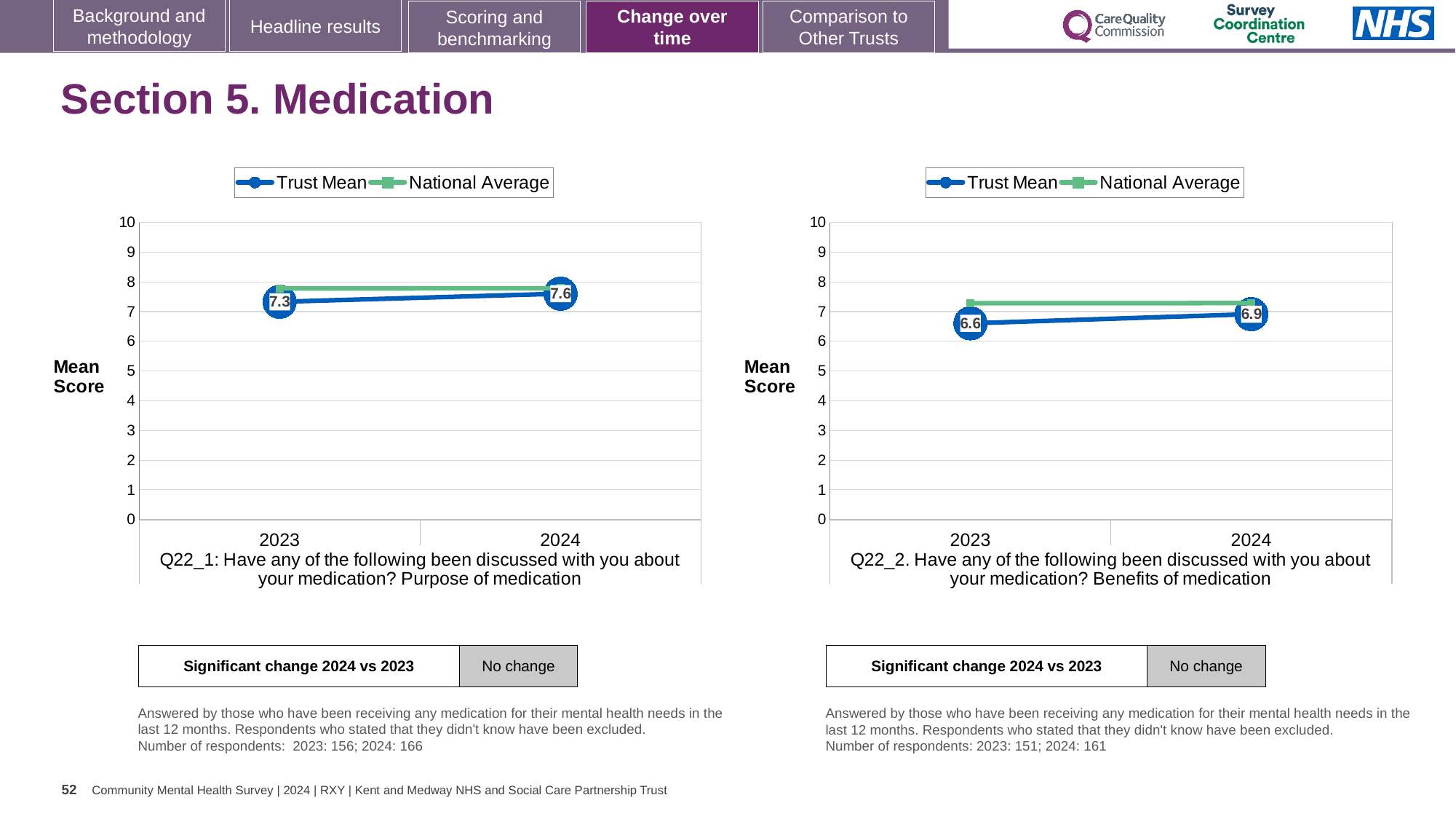
In the Q22_1 Purpose of medication chart, what is the Trust Mean for 2023? 7.3 In the Q22_2 Benefits of medication chart, what is the Trust Mean for 2023? 6.6 In the Q22_1 Purpose of medication chart, is the National Average for 2023 greater or less than 7? greater In the Q22_2 Benefits of medication chart, which is higher in 2023, the Trust Mean or the National Average? National Average In the Q22_2 Benefits of medication chart, which year has the higher Trust Mean? 2024 In the Q22_2 Benefits of medication chart, what is the Trust Mean for 2024? 6.9 How many series does the legend of the Q22_2 Benefits of medication chart list? 2 In the Q22_1 Purpose of medication chart, what is the Trust Mean for 2024? 7.6 In the Q22_2 Benefits of medication chart, what is the difference between the Trust Mean in 2024 and 2023? 0.3 What kind of chart is the Q22_1 Purpose of medication chart? line chart In the Q22_1 Purpose of medication chart, does the Trust Mean rise or fall from 2023 to 2024? rise In the Q22_1 Purpose of medication chart, by how much did the Trust Mean change from 2023 to 2024? 0.3